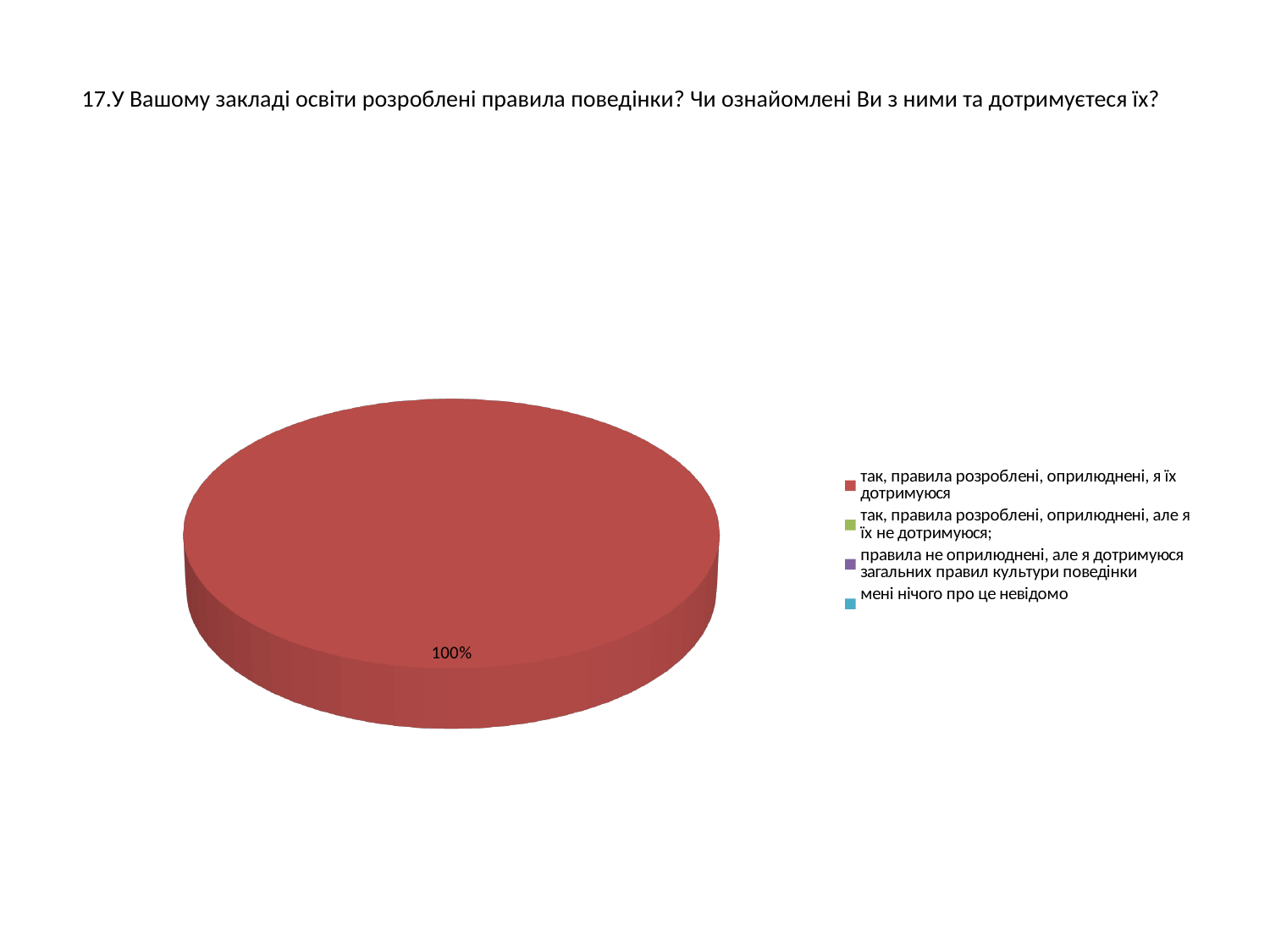
How many slices are visible in the pie chart? 1 What percentage is printed on the pie chart's slice? 100% What share of the pie does the category "так, правила розроблені, оприлюднені, я їх дотримуюся" take? 100% What is the last entry listed in the pie chart's legend? мені нічого про це невідомо What kind of chart is shown on the slide? pie chart Which category accounts for the largest share of the pie chart? так, правила розроблені, оприлюднені, я їх дотримуюся How many entries does the legend of the pie chart list? 4 What colour is the slice labelled 100% in the pie chart? red